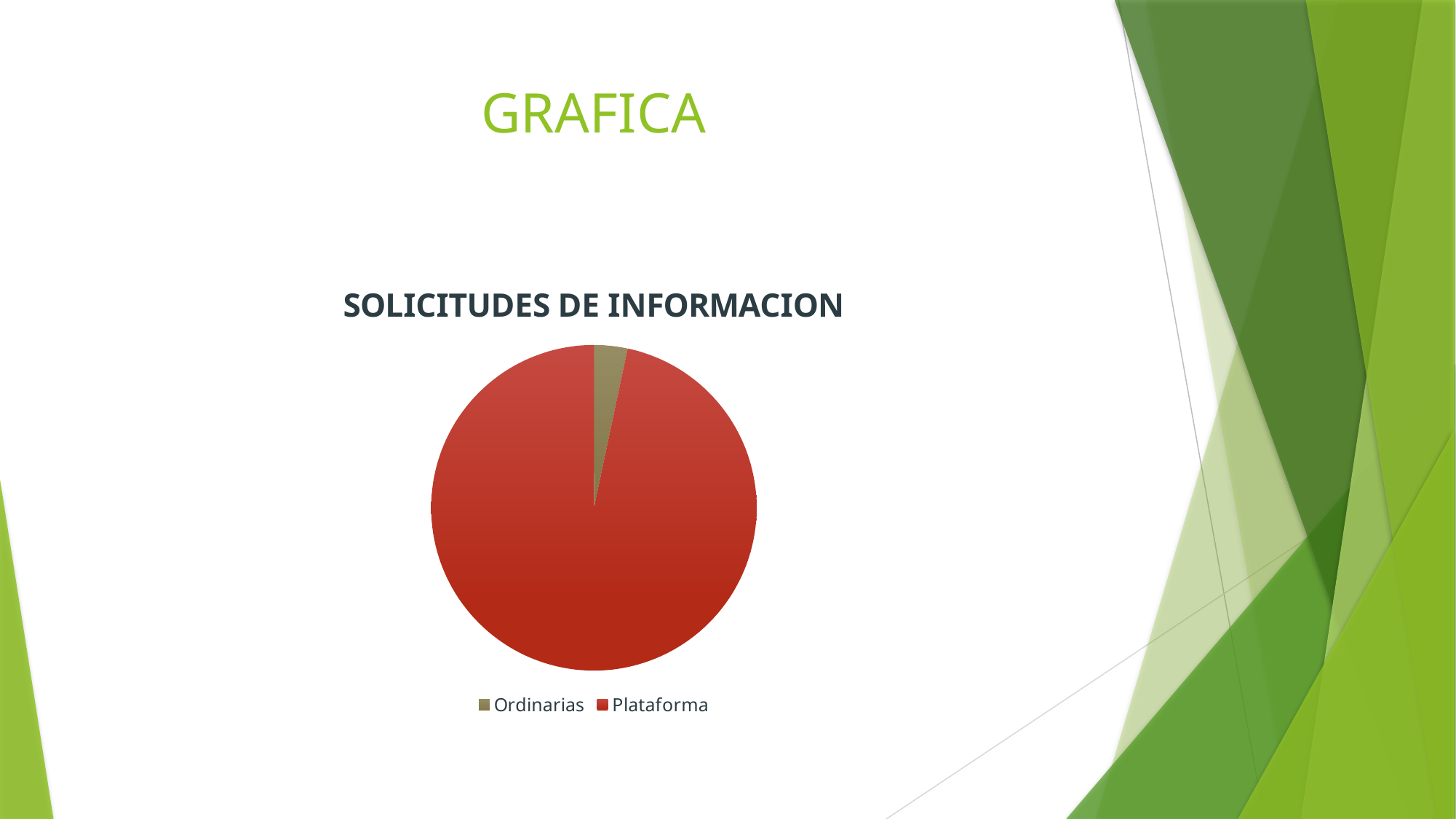
What colour is the Plataforma slice in the chart? red What is the title of the chart? SOLICITUDES DE INFORMACION What kind of chart is shown on the slide? pie chart Which category has the smallest slice of the pie? Ordinarias Which legend entry is listed first in the chart's legend? Ordinarias Which category has the largest slice of the pie? Plataforma Which slice is larger, Ordinarias or Plataforma? Plataforma How many categories does the legend of the chart list? 2